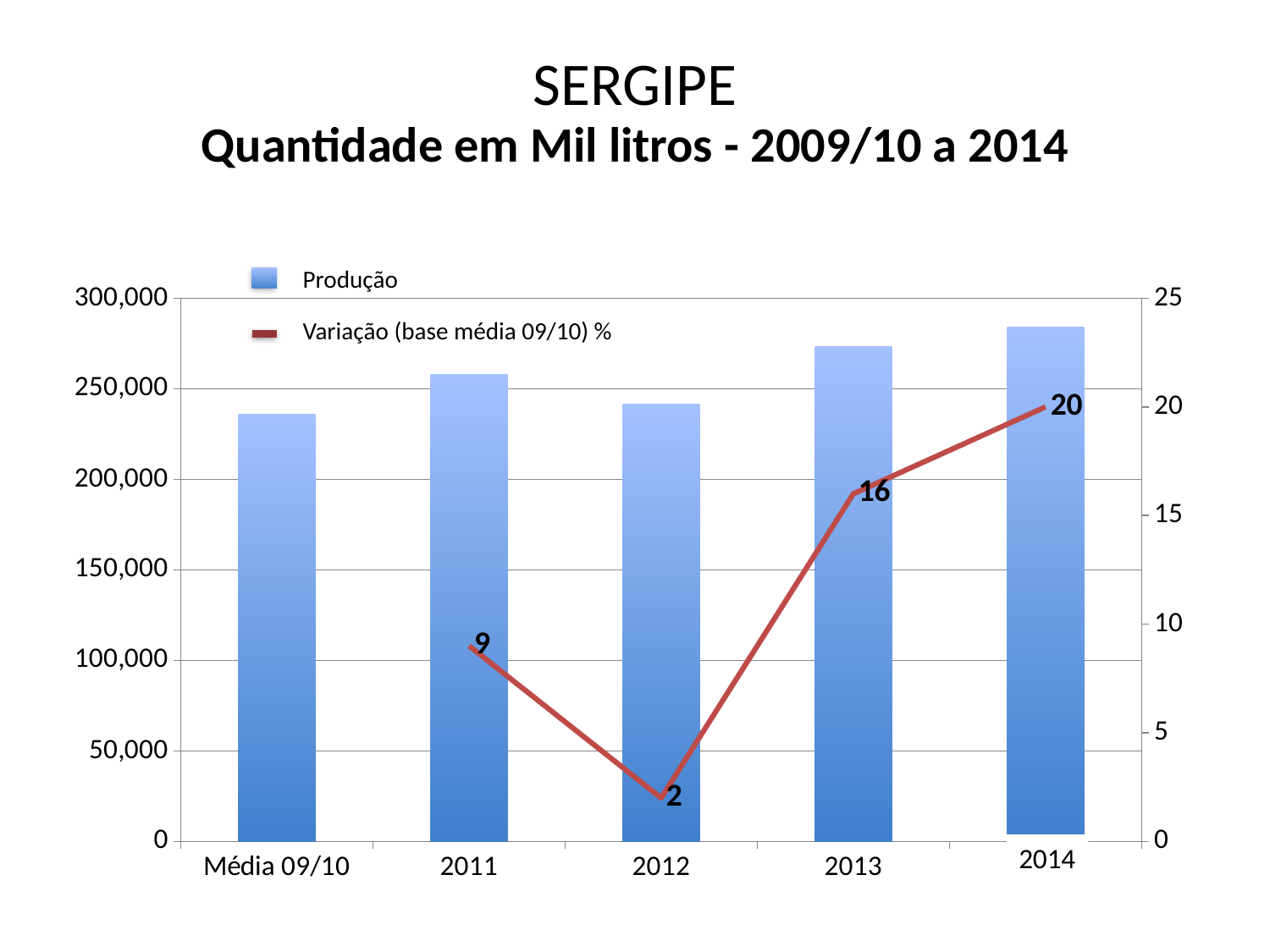
In which year is the Variação (base média 09/10) % highest? 2014 In which year is the Variação (base média 09/10) % lowest? 2012 What is the value of Variação (base média 09/10) % for 2013? 16 Is the Produção value for Média 09/10 greater or less than 250,000? less Is the Produção value for 2014 greater or less than 250,000? greater What is the value of Variação (base média 09/10) % for 2014? 20 What is the value of Variação (base média 09/10) % for 2012? 2 Which category has the highest Produção bar? 2014 How many series does the legend list? 2 How many categories are shown on the x axis? 5 What is the difference between the Variação values for 2014 and 2011? 11 Which year has a larger Variação value, 2011 or 2013? 2013